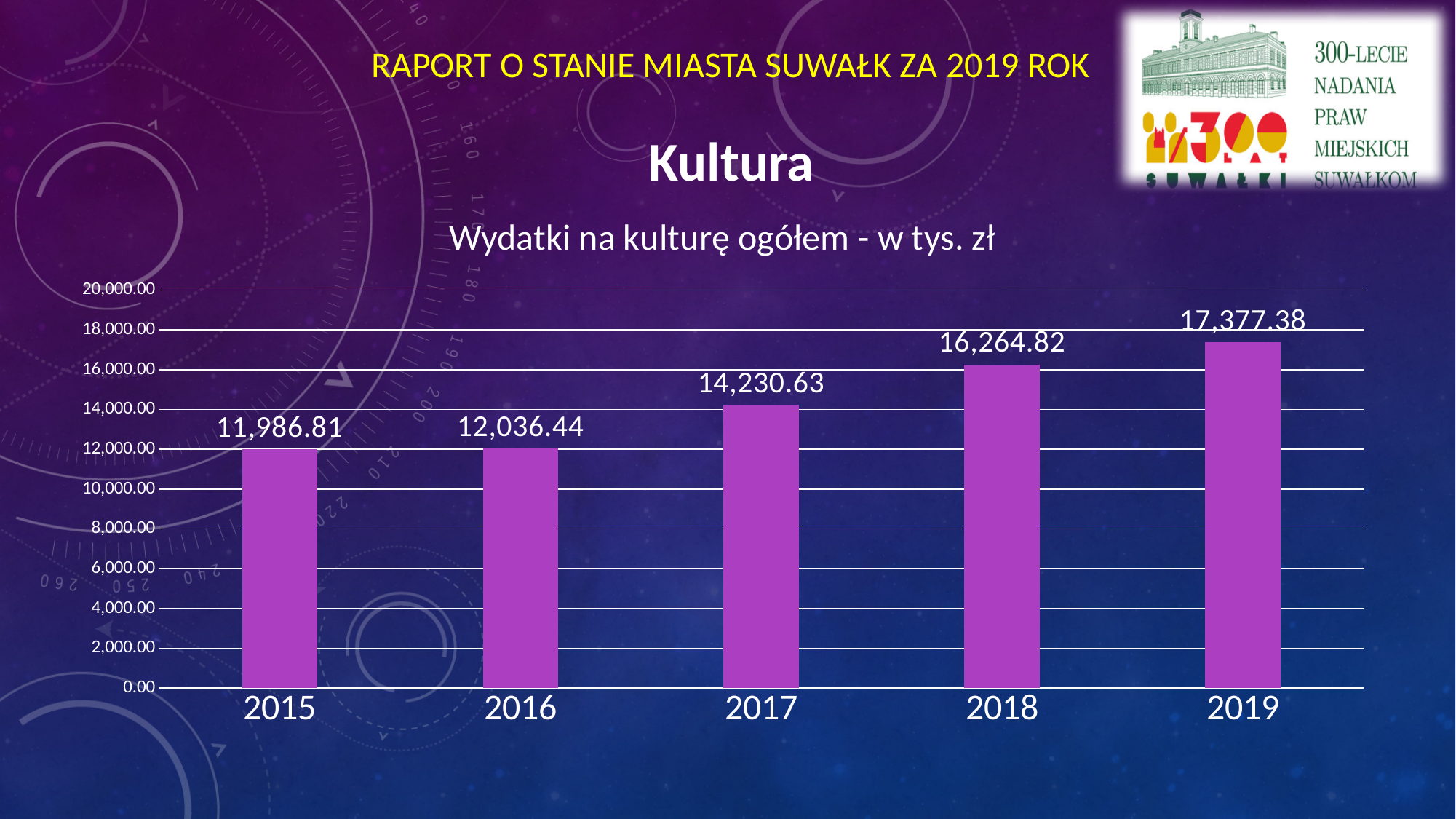
What is the value for 2017 in the chart? 14,230.63 Which is larger, the value for 2016 or the value for 2015? 2016 What is the difference between the values for 2017 and 2016? 2,194.19 What is the value for 2019 in the chart? 17,377.38 Which year has the highest value in the chart? 2019 What kind of chart is shown on the slide? bar chart What is the value for 2015 in the chart? 11,986.81 Do the values rise or fall from 2015 to 2019? rise How many years are shown on the x axis of the chart? 5 Which year has the lowest value in the chart? 2015 Is the value for 2018 greater or less than 16,000.00? greater What is the difference between the values for 2019 and 2018? 1,112.56